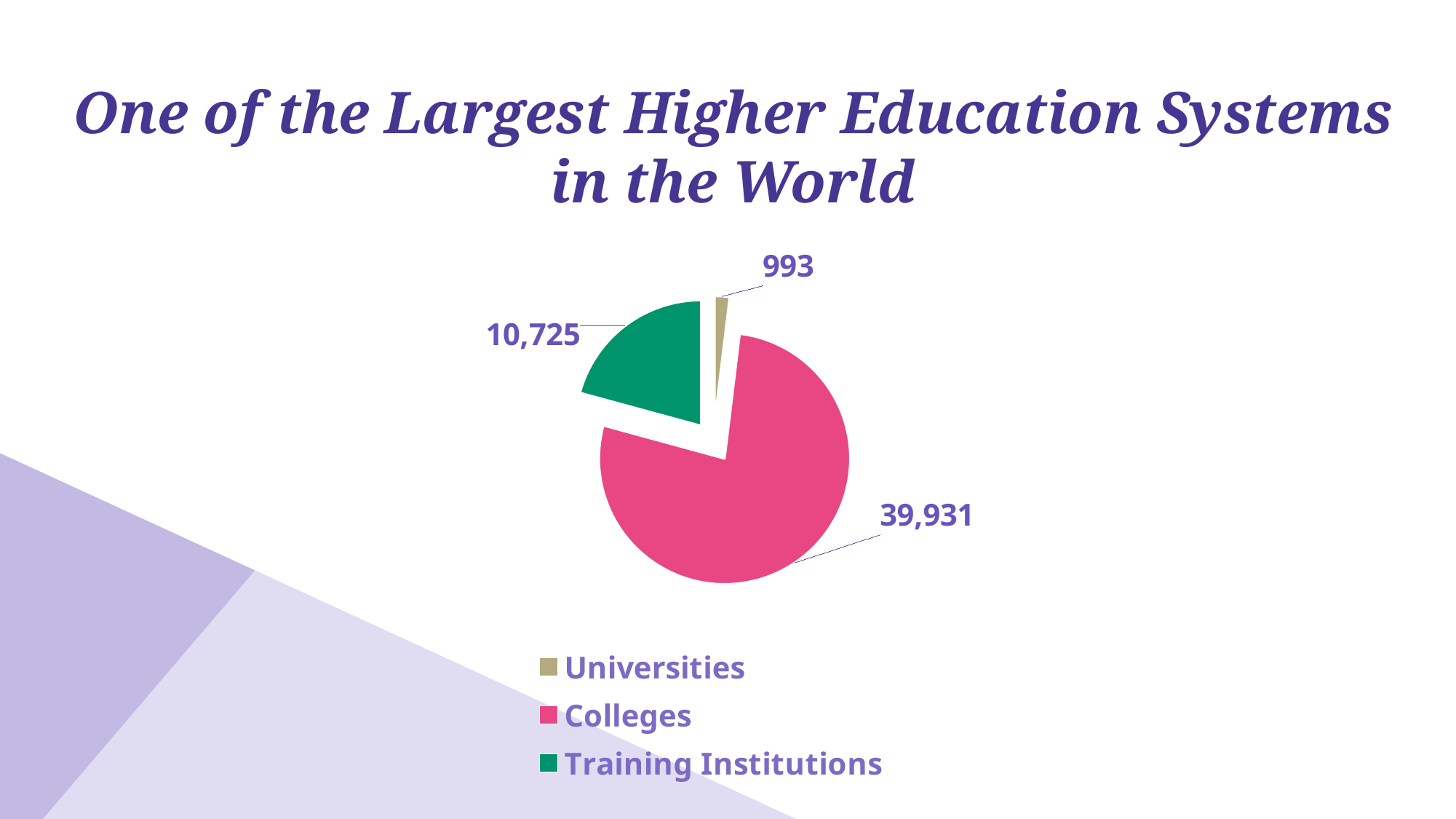
What is the value for Universities? 993 What is the title of the slide containing the pie chart? One of the Largest Higher Education Systems in the World What is the value for Training Institutions? 10,725 How many categories does the pie chart have? 3 Which category has the largest slice of the pie? Colleges What is the difference between the values for Colleges and Training Institutions? 29,206 Which is larger, the value for Training Institutions or the value for Universities? Training Institutions What is the value for Colleges? 39,931 What type of chart is shown on the slide? pie chart What is the total of all three slices in the pie chart? 51,649 What is the difference between the values for Training Institutions and Universities? 9,732 Which category has the smallest slice of the pie? Universities